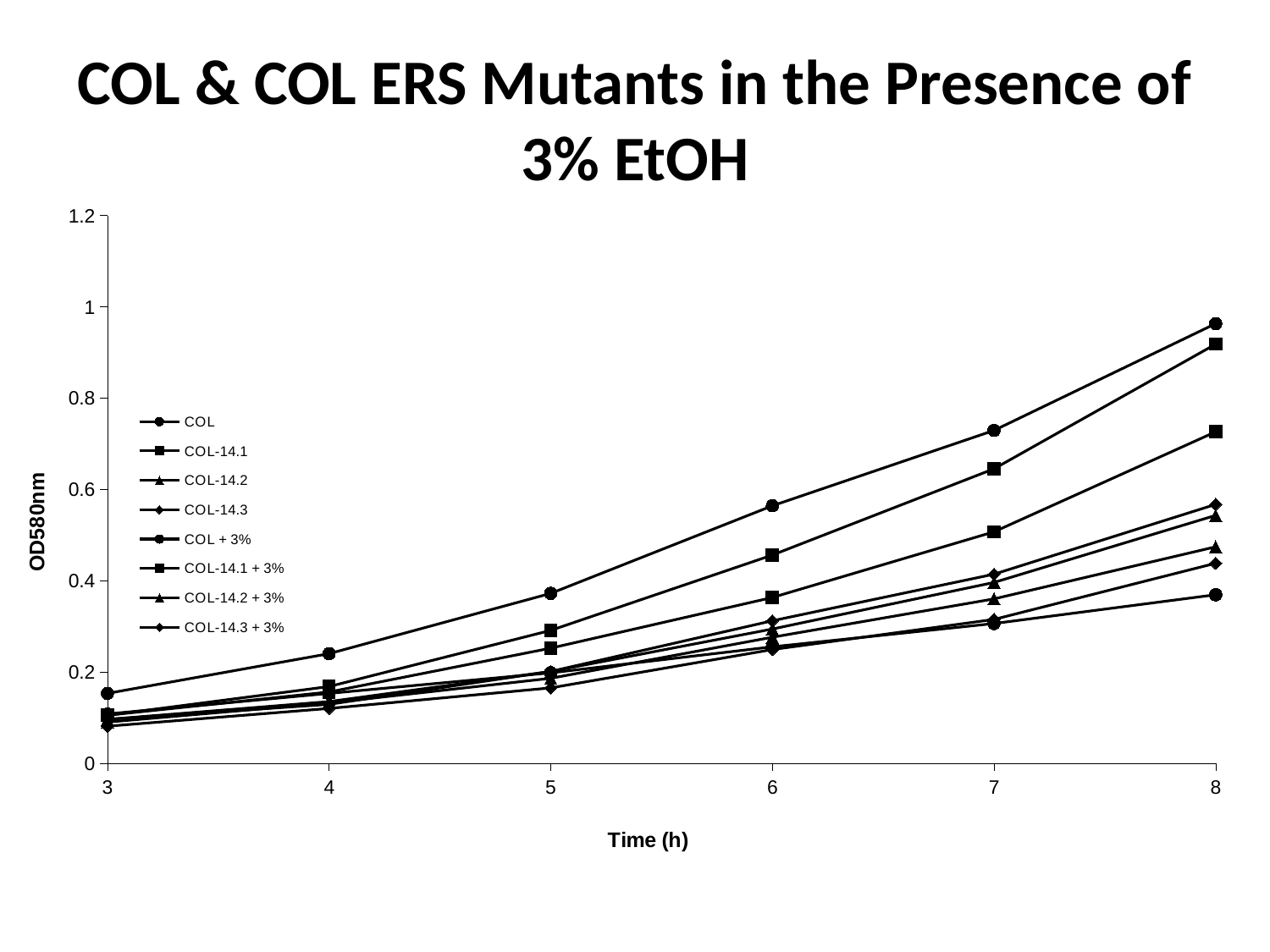
What is the label of the y axis? OD580nm What is the title of the chart? COL & COL ERS Mutants in the Presence of 3% EtOH How many time points are plotted along the x axis? 6 Is the lowest value plotted at 3 h greater or less than 0.2? less Is the highest value plotted at 6 h greater or less than 0.4? greater At which time point do the plotted values reach their highest level? 8 Is the lowest value plotted at 8 h greater or less than 0.6? less What kind of chart is shown on the slide? line chart How many series does the legend list? 8 Do the plotted OD580nm values rise or fall as time increases from 3 h to 8 h? rise At which time point are the plotted values lowest? 3